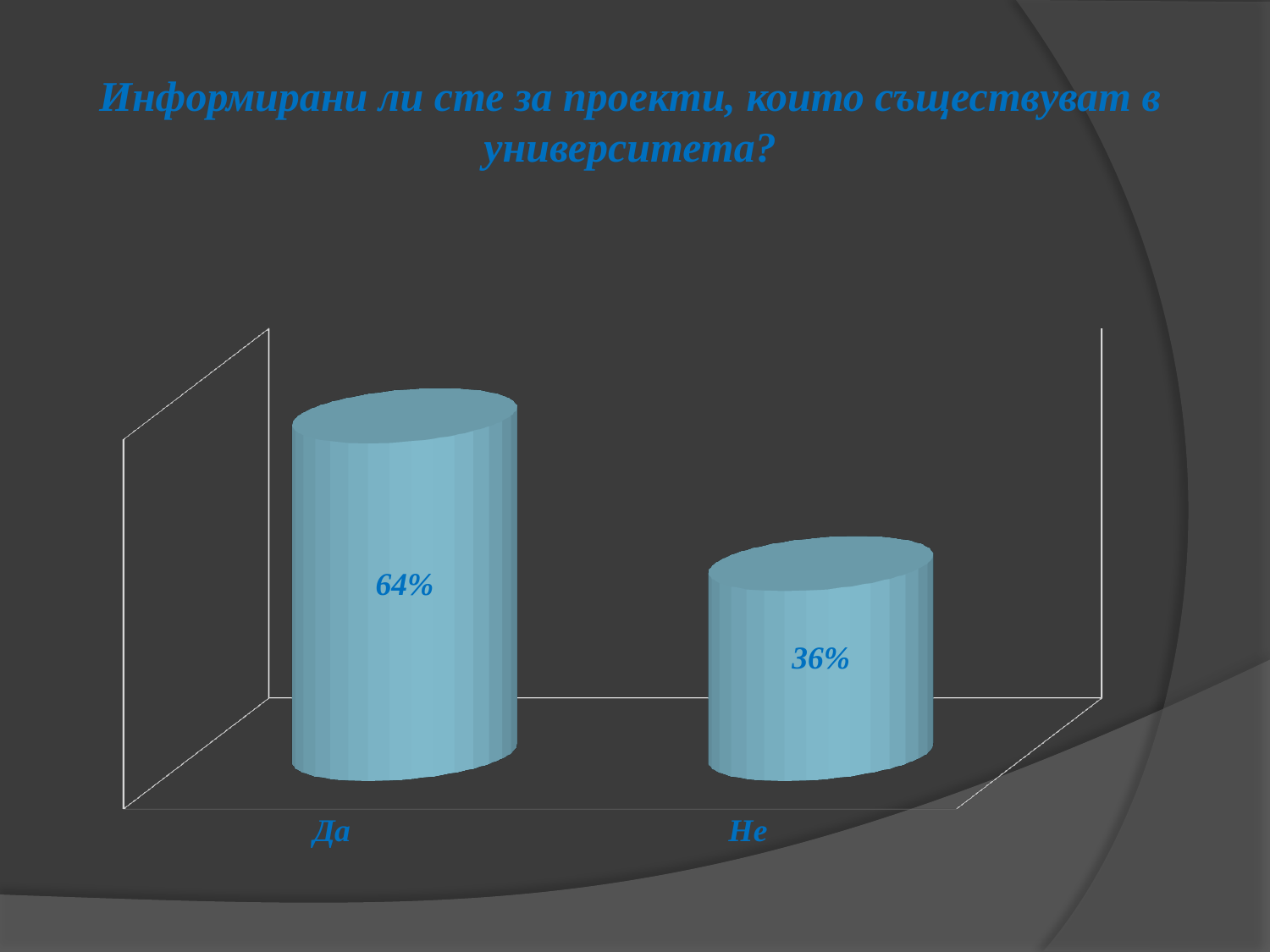
What is the difference between the values for "Да" and "Не"? 28% Which category has the lowest value? Не Which is larger, the value for "Да" or the value for "Не"? Да What colour are the bars in the chart? Light blue What is the title of the chart? Информирани ли сте за проекти, които съществуват в университета? Which category has the highest value? Да What is the total of the two values shown in the chart? 100% How many categories are shown in the chart? 2 What is the value for "Да"? 64% What kind of chart is shown on the slide? Bar chart What is the value for "Не"? 36%